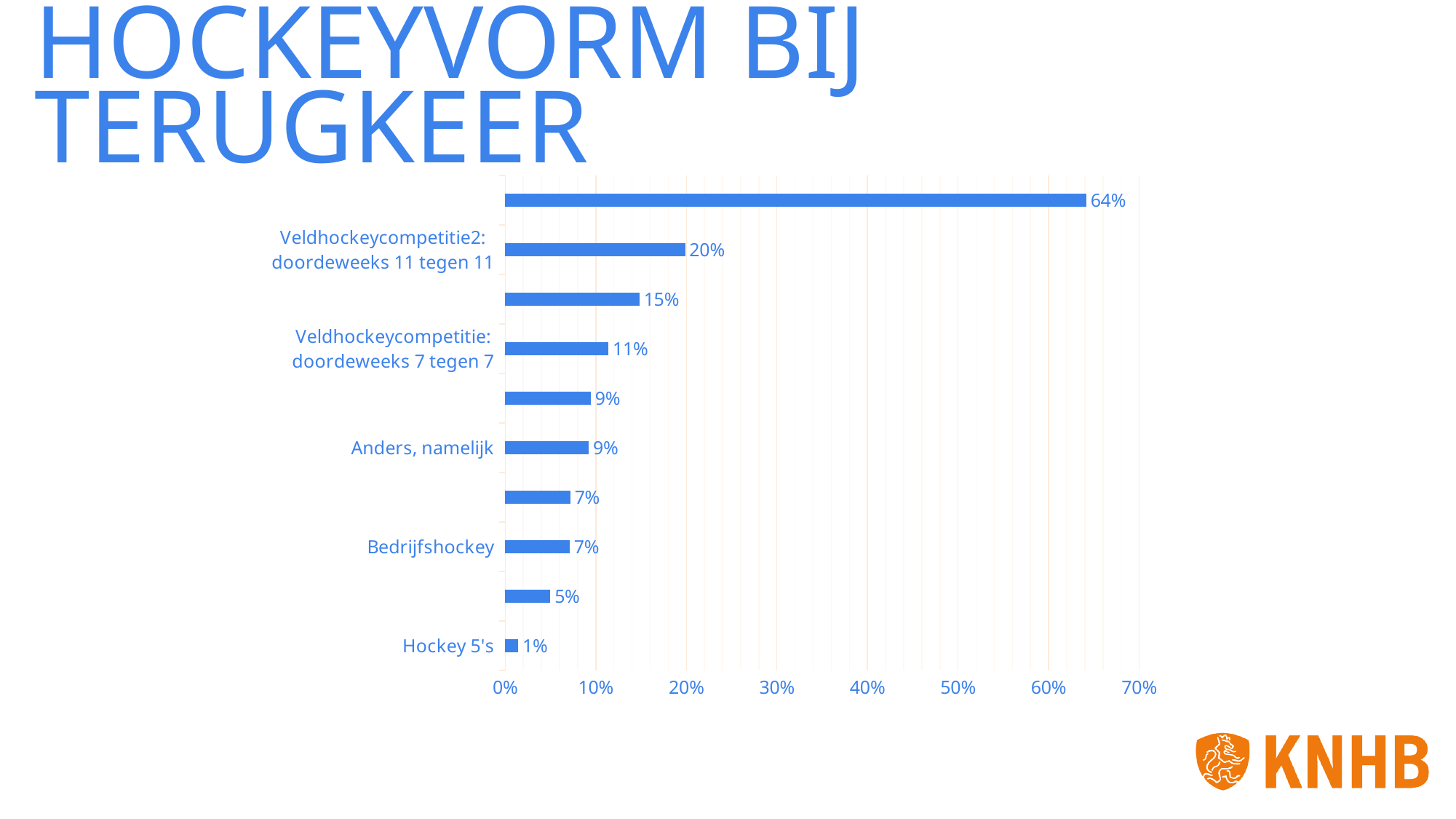
What is the title of the slide? HOCKEYVORM BIJ TERUGKEER What is the value for Anders, namelijk? 9% Which category has the lowest value? Hockey 5's What is the value for Veldhockeycompetitie: doordeweeks 7 tegen 7? 11% Which is larger, Bedrijfshockey or Anders, namelijk? Anders, namelijk What is the value for Bedrijfshockey? 7% What is the value for Hockey 5's? 1% What kind of chart is shown on the slide? bar chart How many bars are plotted in the chart? 10 What is the value for Veldhockeycompetitie2: doordeweeks 11 tegen 11? 20% What is the highest value shown in the chart? 64% What is the difference between Veldhockeycompetitie2: doordeweeks 11 tegen 11 and Veldhockeycompetitie: doordeweeks 7 tegen 7? 9%